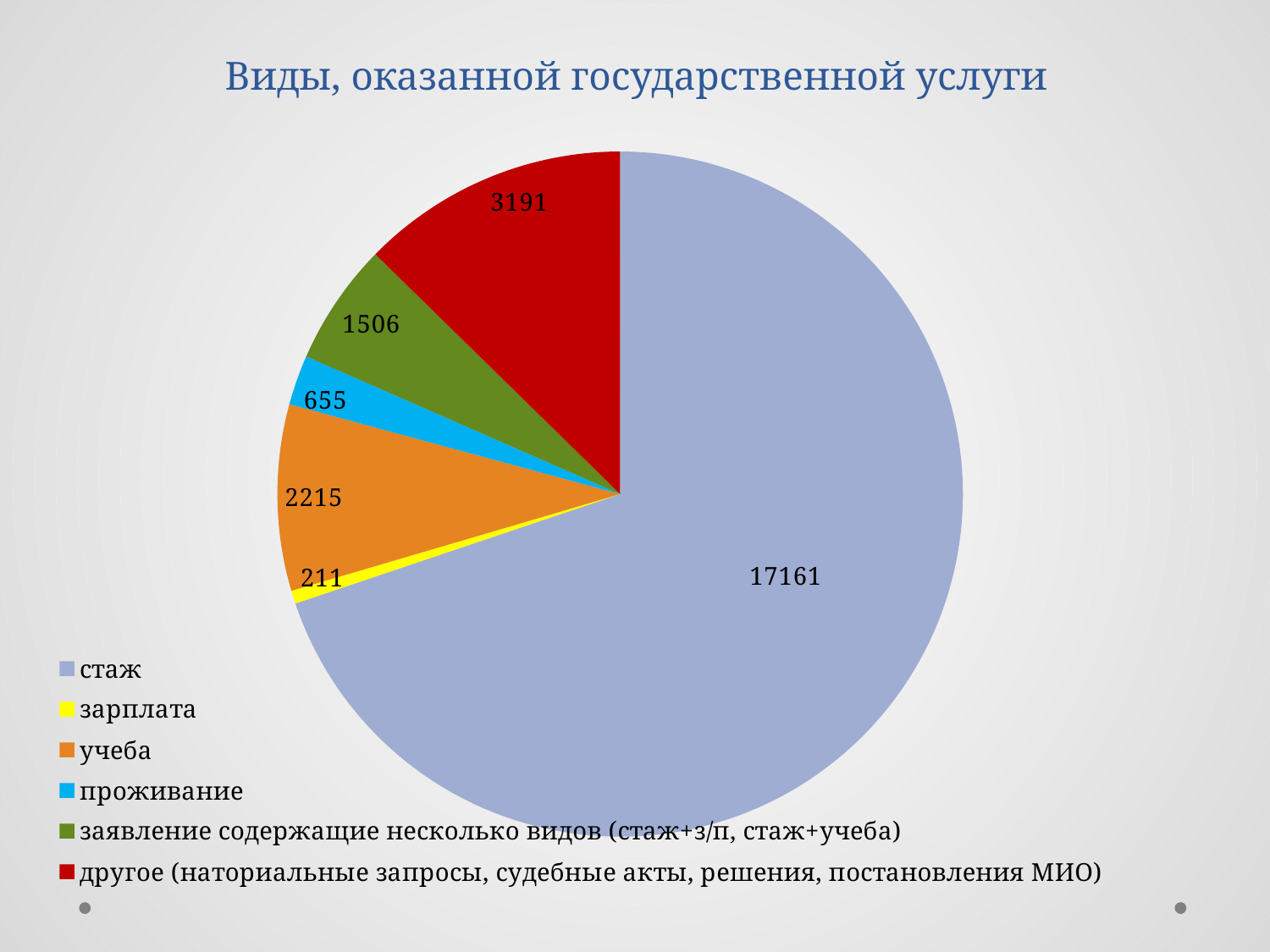
Which category has the largest slice? стаж What is the difference between the value for другое (наториальные запросы, судебные акты, решения, постановления МИО) and the value for заявление содержащие несколько видов (стаж+з/п, стаж+учеба)? 1685 How many categories does the legend list? 6 What is the value for стаж? 17161 What type of chart is shown on the slide? pie chart What colour is the slice for другое (наториальные запросы, судебные акты, решения, постановления МИО)? red Which category has the smallest slice? зарплата What is the value for зарплата? 211 Which is larger, the value for учеба or the value for проживание? учеба What is the title of the chart? Виды, оказанной государственной услуги What is the value for проживание? 655 What is the value for учеба? 2215